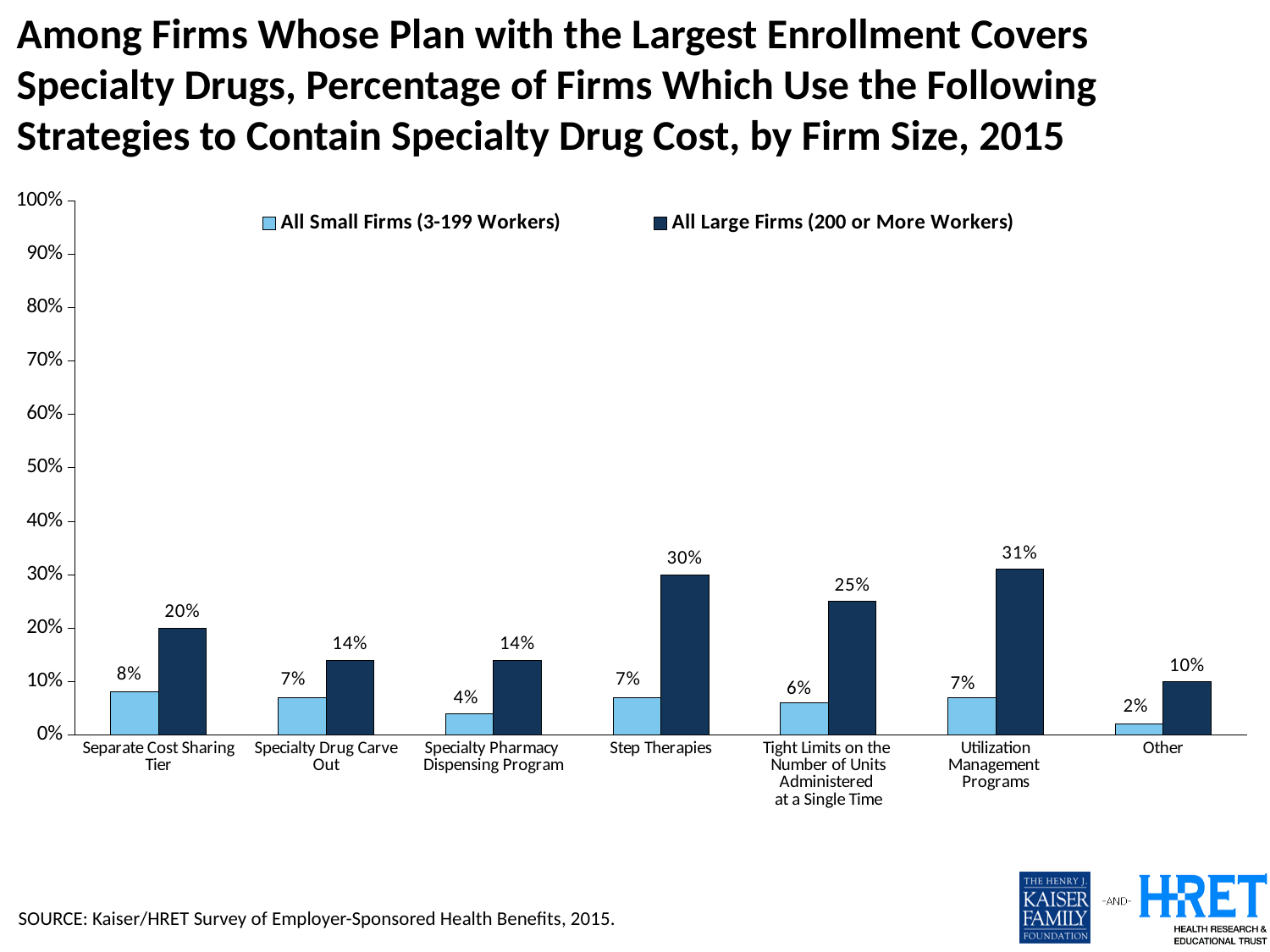
Is the value for All Large Firms (200 or More Workers) for Step Therapies greater or less than 20%? greater What is the difference between All Large Firms and All Small Firms for Tight Limits on the Number of Units Administered at a Single Time? 19% What percentage of All Small Firms (3-199 Workers) use a Specialty Pharmacy Dispensing Program? 4% Which strategy has the highest value for All Large Firms (200 or More Workers)? Utilization Management Programs Which is larger for Separate Cost Sharing Tier: All Small Firms (3-199 Workers) or All Large Firms (200 or More Workers)? All Large Firms (200 or More Workers) Which strategy has the lowest value for All Small Firms (3-199 Workers)? Other What kind of chart is shown on the slide? Bar chart How many series does the legend list? 2 What percentage of All Large Firms (200 or More Workers) use Step Therapies? 30% How many strategy categories are shown on the x axis? 7 What is the source cited at the bottom of the slide? Kaiser/HRET Survey of Employer-Sponsored Health Benefits, 2015 What percentage of All Large Firms (200 or More Workers) use Utilization Management Programs? 31%